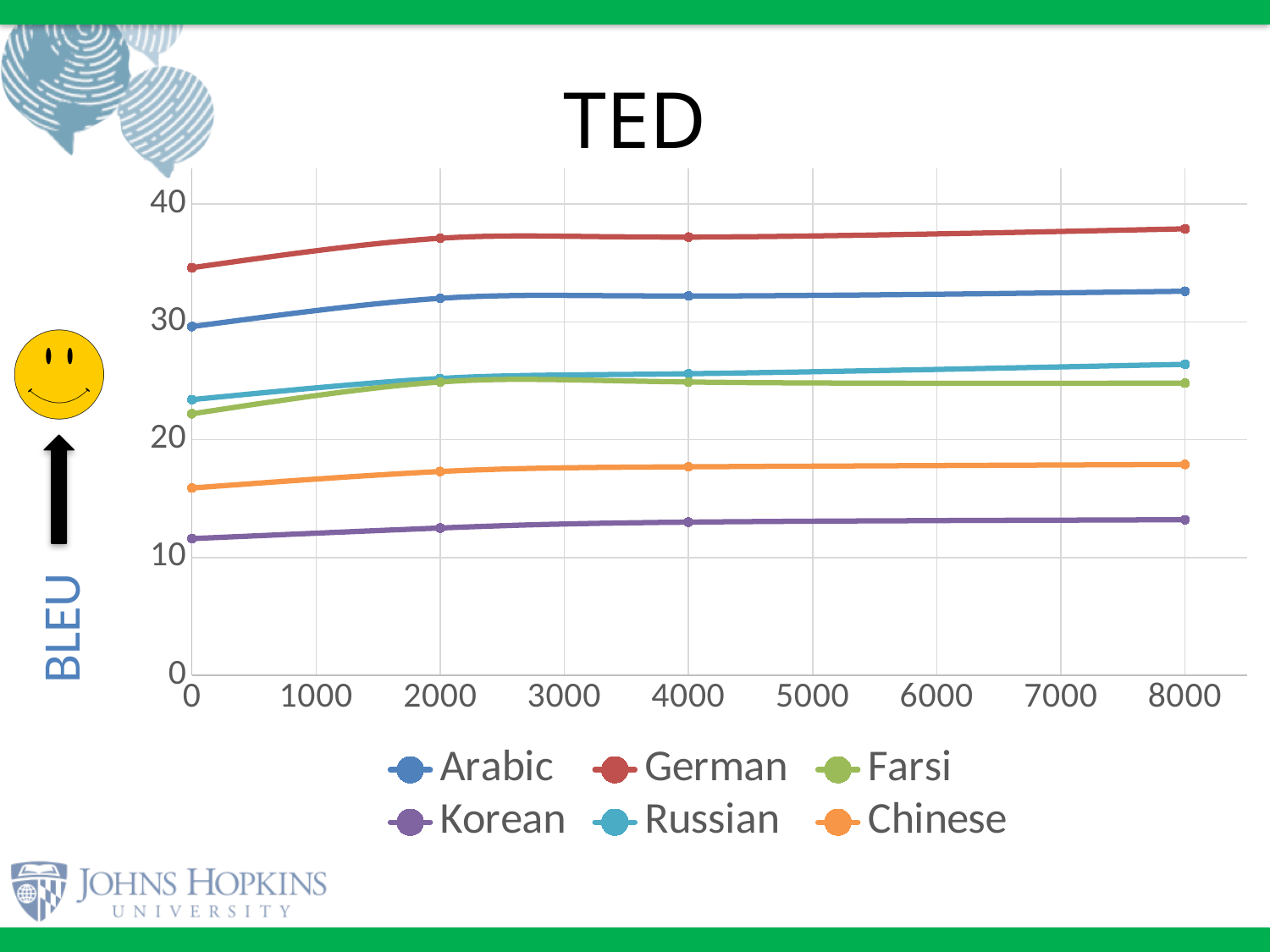
Which language has the highest BLEU score at 8000? German How many series does the legend list? 6 What is the title of the chart? TED At 8000, which has the larger BLEU score, Arabic or German? German What is the label of the y axis? BLEU Does the BLEU score for German rise or fall as the x-axis value increases from 0 to 8000? rise How many data points are plotted for the German series? 4 Which language has the lowest BLEU score at 8000? Korean Is the BLEU value for German at 0 greater or less than 30? greater Is the BLEU value for Korean at 8000 greater or less than 20? less What kind of chart is shown on the slide? line chart Is the BLEU value for Chinese at 0 greater or less than 20? less